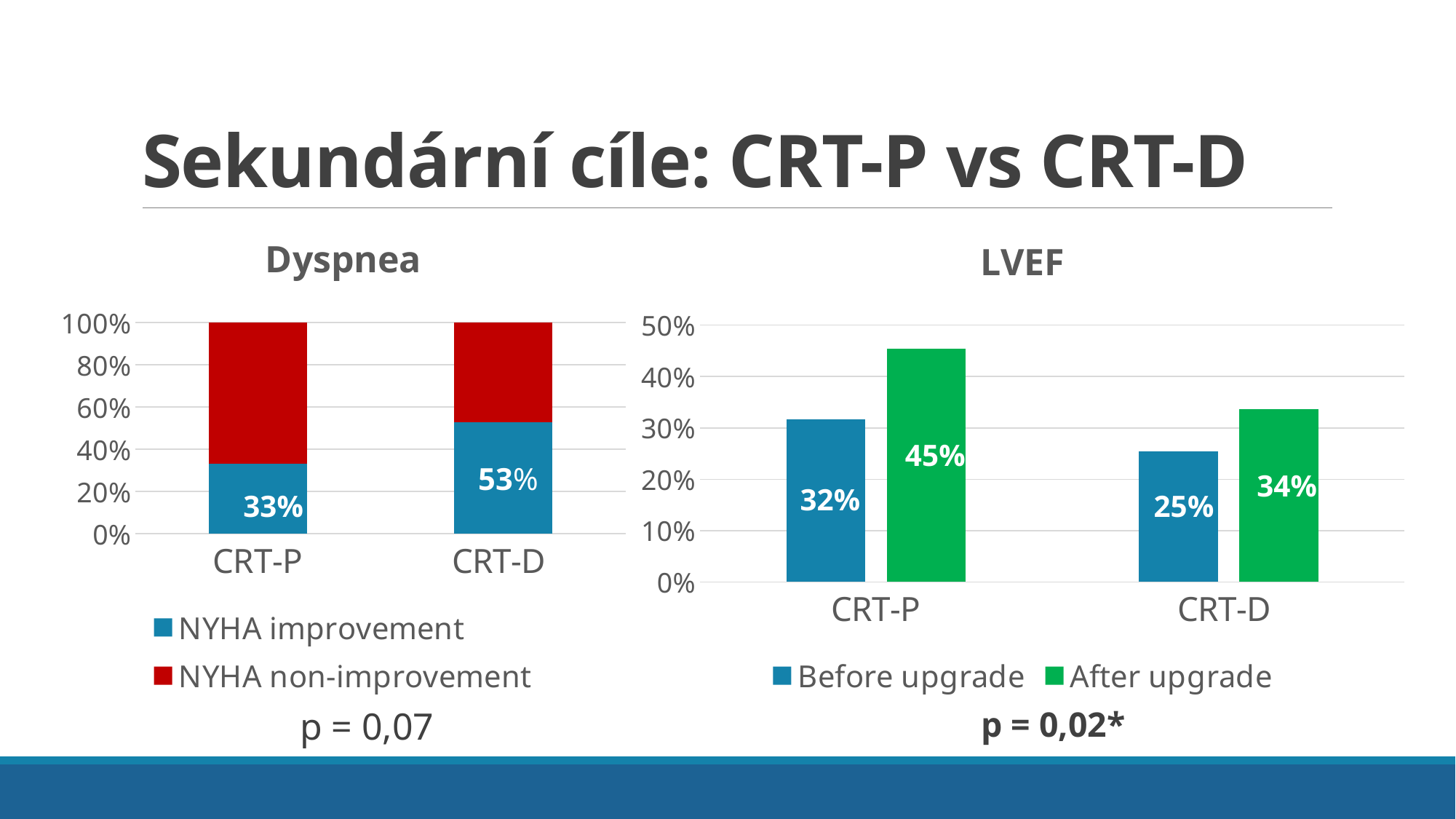
In the Dyspnea chart, what is the NYHA improvement value for CRT-D? 53% In the LVEF chart, what is the Before upgrade value for CRT-P? 32% In the Dyspnea chart, what is the NYHA improvement value for CRT-P? 33% In the Dyspnea chart, what is the difference between the NYHA improvement values for CRT-D and CRT-P? 20% In the Dyspnea chart, is the NYHA non-improvement portion for CRT-P greater or less than 60%? greater In the LVEF chart, which bar has the highest value? CRT-P After upgrade In the LVEF chart, what is the After upgrade value for CRT-D? 34% In the LVEF chart, which bar has the lowest value? CRT-D Before upgrade In the Dyspnea chart, how many series does the legend list? 2 In the Dyspnea chart, which group has the higher NYHA improvement value, CRT-P or CRT-D? CRT-D What kind of chart is the LVEF chart? Bar chart In the LVEF chart, what is the difference between the After upgrade and Before upgrade values for CRT-P? 13%